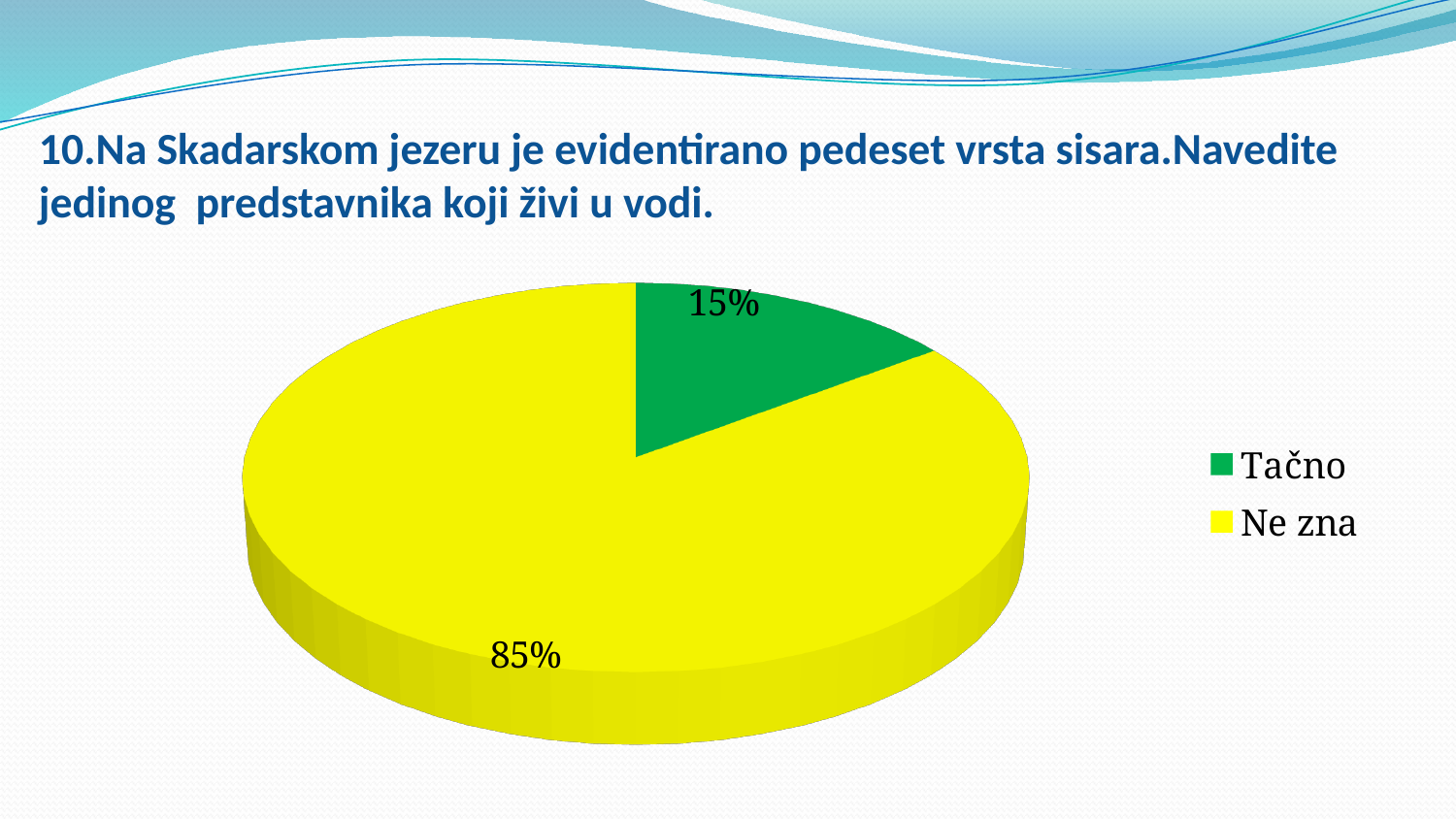
How many slices does the pie chart have? 2 What kind of chart is shown on the slide? pie chart How many entries does the legend list? 2 Which category has the smallest share of the pie? Tačno Which category has the largest share of the pie? Ne zna What colour is the Ne zna slice? yellow What share of the pie does the Tačno slice represent? 15% What colour is the Tačno slice? green Which slice is larger, Tačno or Ne zna? Ne zna What percentage of the pie is labelled Ne zna? 85% What is the difference in percentage points between the Ne zna and Tačno slices? 70 What percentage of the pie is labelled Tačno? 15%